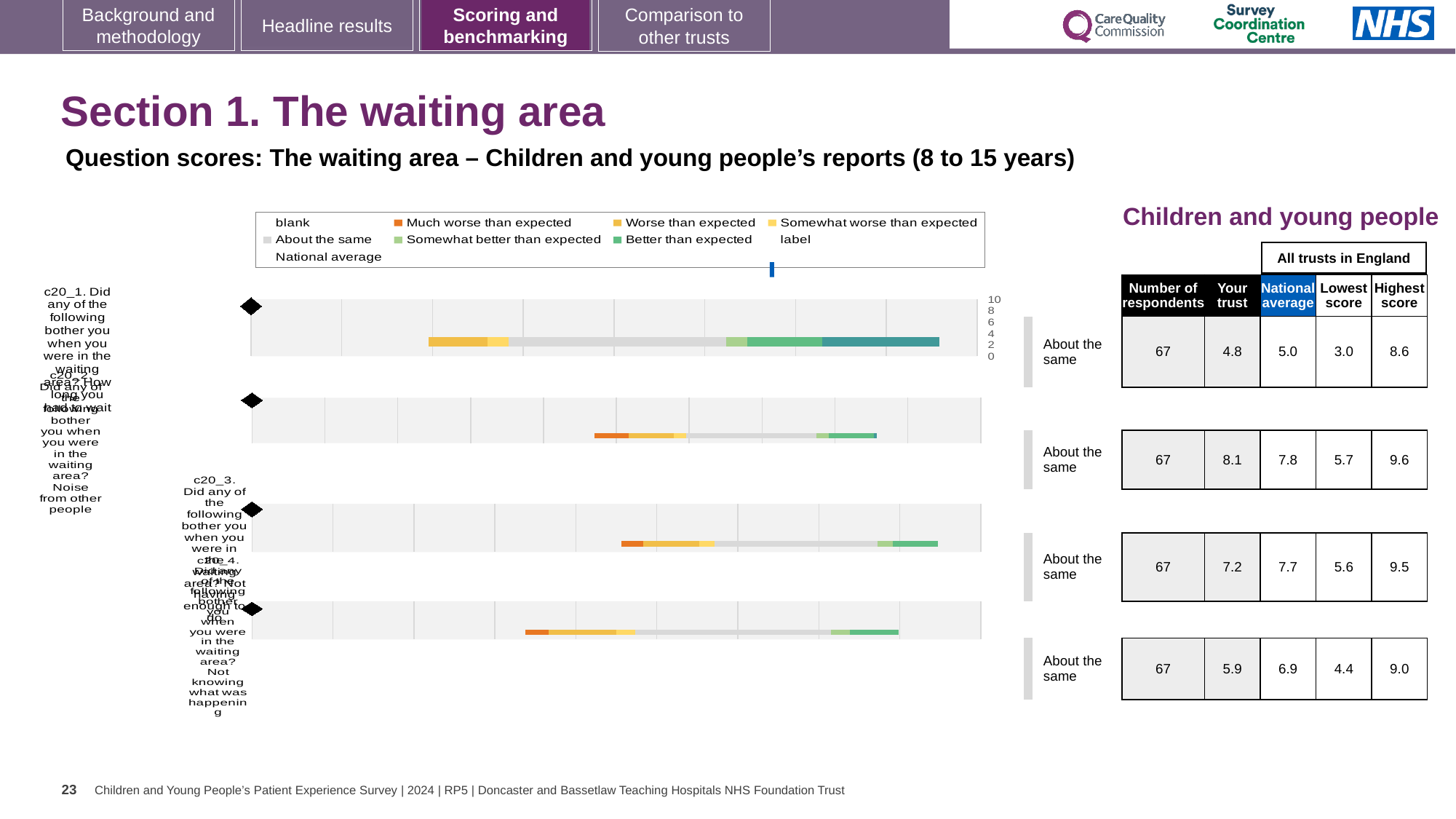
Which question has the lowest 'Your trust' score? c20_1 (How long you had to wait) In the legend, what colour represents 'Much worse than expected'? orange Which question has the highest 'Your trust' score? c20_2 (Noise from other people) What is the highest score across all trusts in England for c20_3 (Not having enough to do)? 9.5 How many respondents are reported for c20_4 (Not knowing what was happening)? 67 In the legend, which category is shown in light grey? About the same What kind of chart is used to show the question scores on this slide? bar chart For c20_2 (Noise from other people), what is the difference between the 'Your trust' score and the national average? 0.3 How many question rows (c20_1 to c20_4) are plotted on the slide? 4 What is the national average for c20_2 (Noise from other people)? 7.8 What is the 'Your trust' score for c20_1 (How long you had to wait)? 4.8 For c20_4 (Not knowing what was happening), which is larger: the 'Your trust' score or the national average? National average